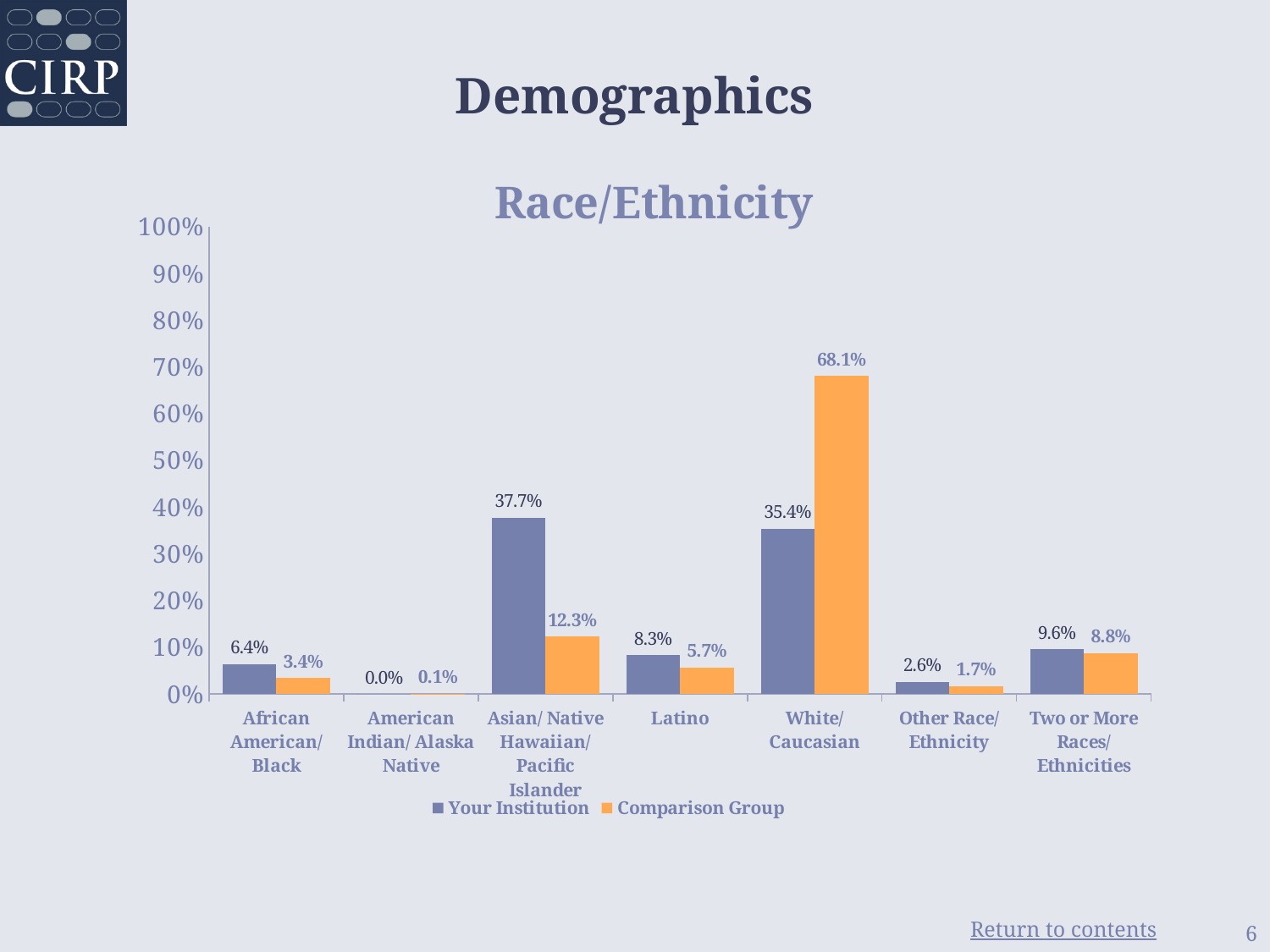
How many race/ethnicity categories are shown on the x axis? 7 Which category has the highest Your Institution value? Asian/ Native Hawaiian/ Pacific Islander What is the difference between the Comparison Group and Your Institution values for White/ Caucasian? 32.7% What is the Comparison Group value for Latino? 5.7% How many series does the legend list? 2 Which category has the lowest Comparison Group value? American Indian/ Alaska Native Which is larger for Two or More Races/ Ethnicities: Your Institution or Comparison Group? Your Institution What kind of chart is shown on the slide? Bar chart What is the Your Institution value for Asian/ Native Hawaiian/ Pacific Islander? 37.7% Is the Your Institution value for White/ Caucasian greater or less than 30%? greater What is the title of the chart? Race/Ethnicity What is the Comparison Group value for White/ Caucasian? 68.1%